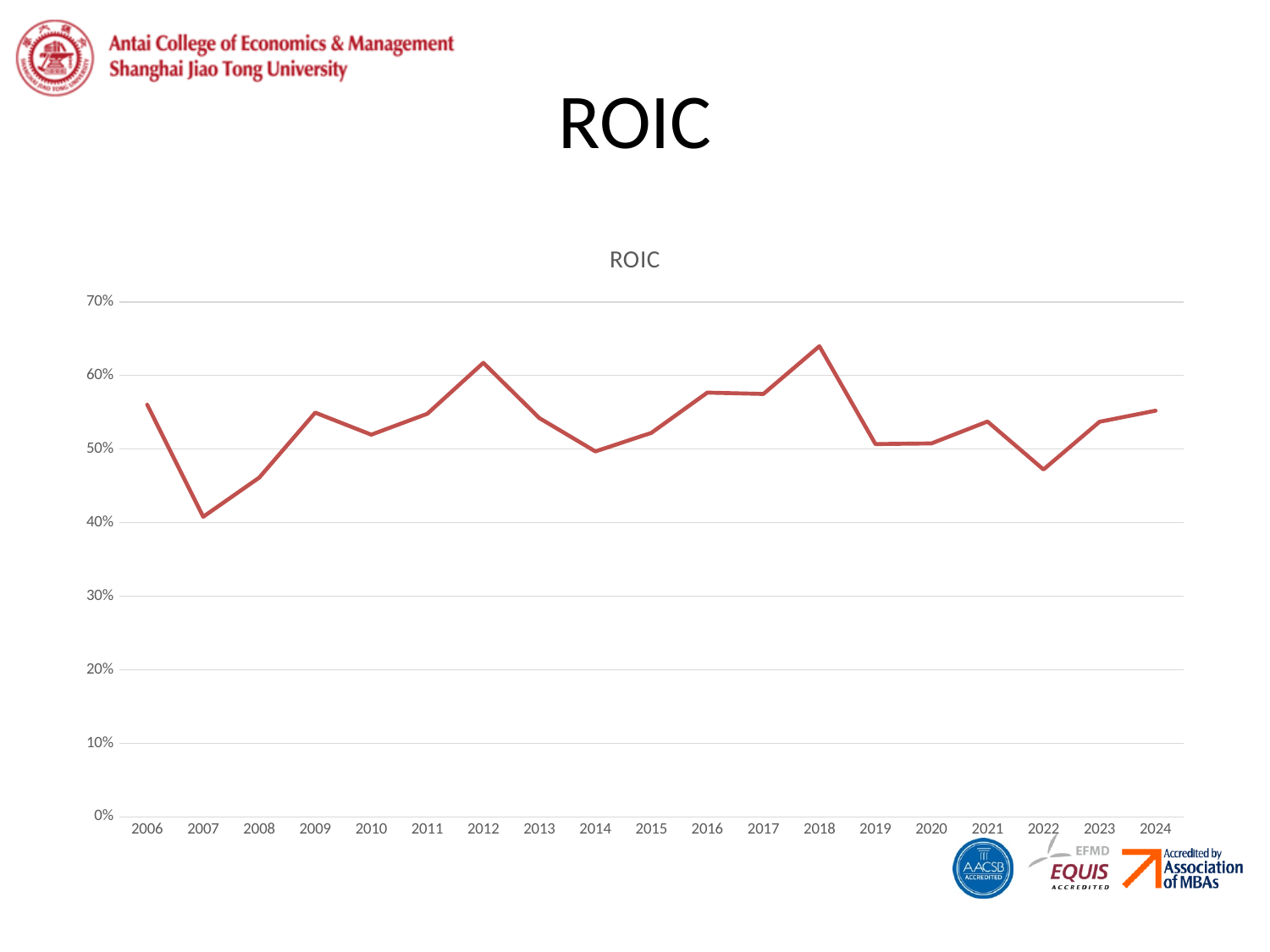
In which year is ROIC lowest? 2007 Is the ROIC value for 2007 greater or less than 50%? less Is the ROIC value for 2016 greater or less than 50%? greater Is the ROIC value for 2022 greater or less than 50%? less How many years are plotted on the x axis of the chart? 19 Does ROIC rise or fall from 2018 to 2019? Fall What is the title of the chart? ROIC Which year has a higher ROIC, 2012 or 2014? 2012 What kind of chart is shown on the slide? Line chart In which year is ROIC highest? 2018 Does ROIC rise or fall from 2022 to 2024? Rise